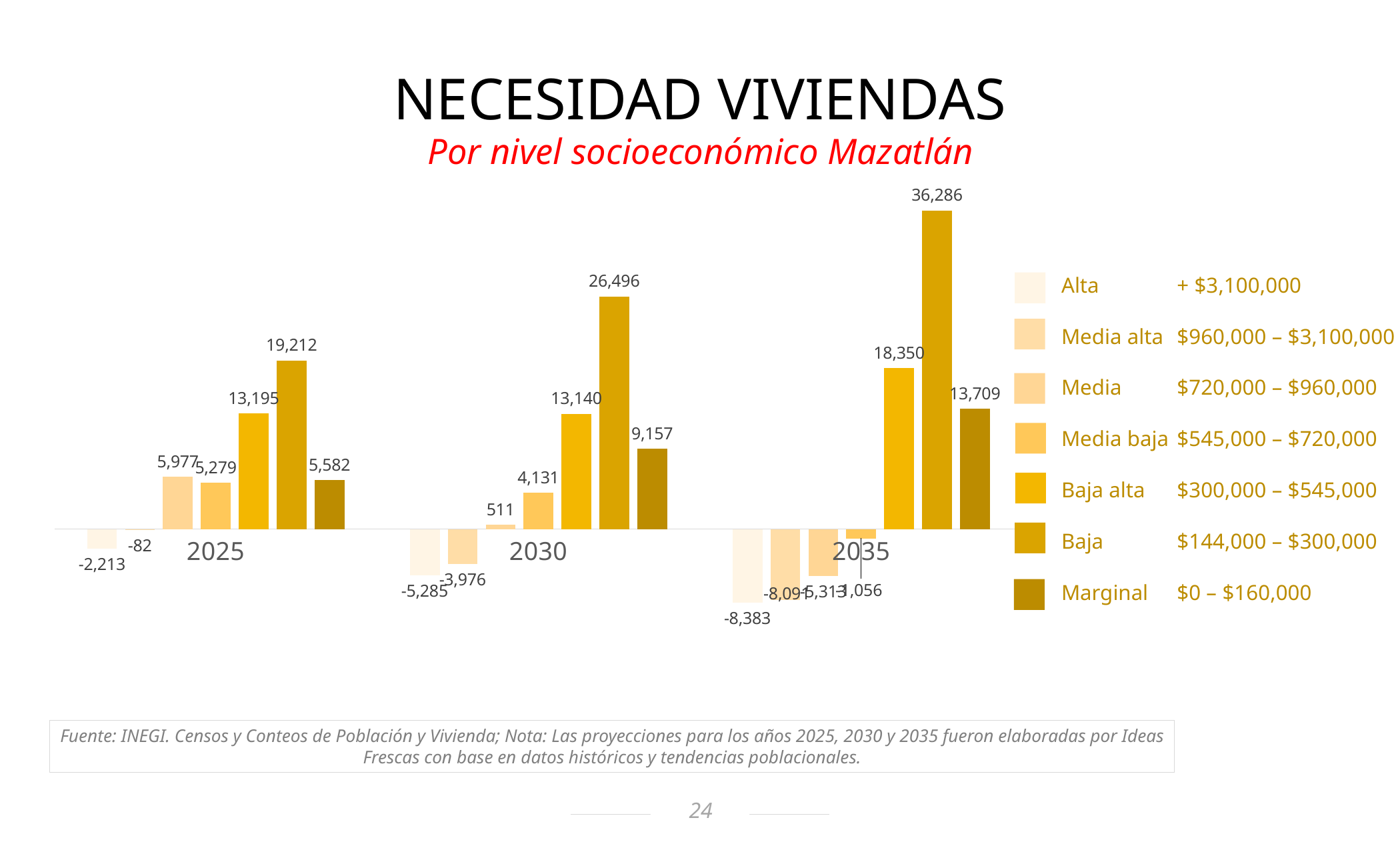
Which series has the lowest value in 2025? Alta What is the value for Baja in 2030? 26,496 How many series does the legend list? 7 What is the value for Baja alta in 2035? 18,350 Does the Baja series rise or fall from 2025 to 2035? Rises What kind of chart is shown on the slide? Bar chart What is the difference between the Baja value in 2035 and the Baja value in 2025? 17,074 What is the value for Media in 2030? 511 In 2030, which is larger: Marginal or Media baja? Marginal In which year is the Baja series highest? 2035 What is the value for Alta in 2025? -2,213 How many years are shown on the x axis? 3